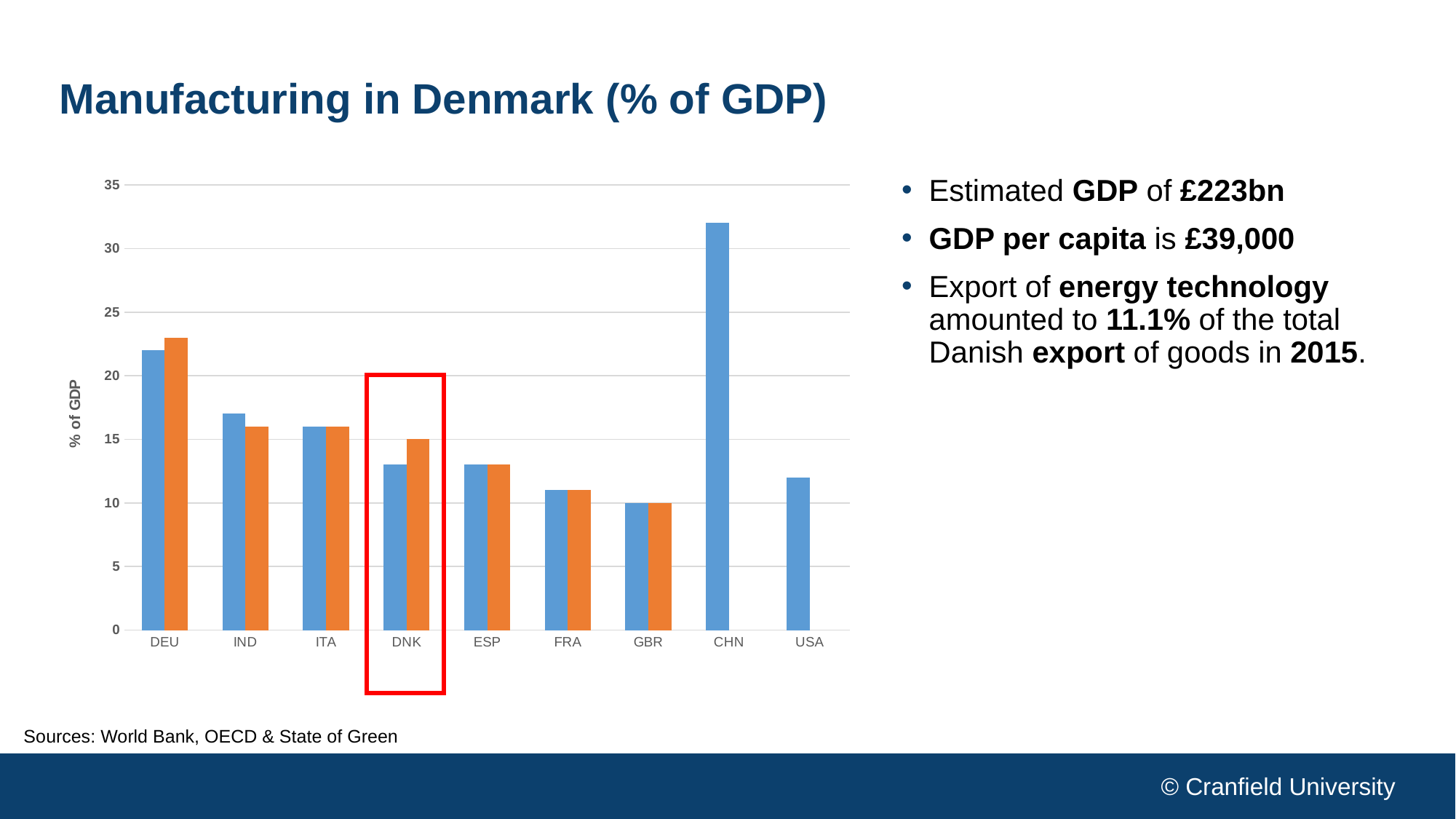
For DNK, which bar is taller, the blue bar or the orange bar? orange Is the value for USA greater or less than 15? less Which country on the x axis is highlighted with a red box? DNK Is the blue bar for DNK greater or less than 15? less How many countries are shown on the x axis of the chart? 9 What kind of chart is shown on the slide? bar chart How many countries in the chart have only a blue bar and no orange bar? 2 Which has the taller blue bar, DEU or IND? DEU Is the blue bar for DEU greater or less than 20? greater Which country has the highest bar in the chart? CHN What is the value of the blue bar for GBR? 10